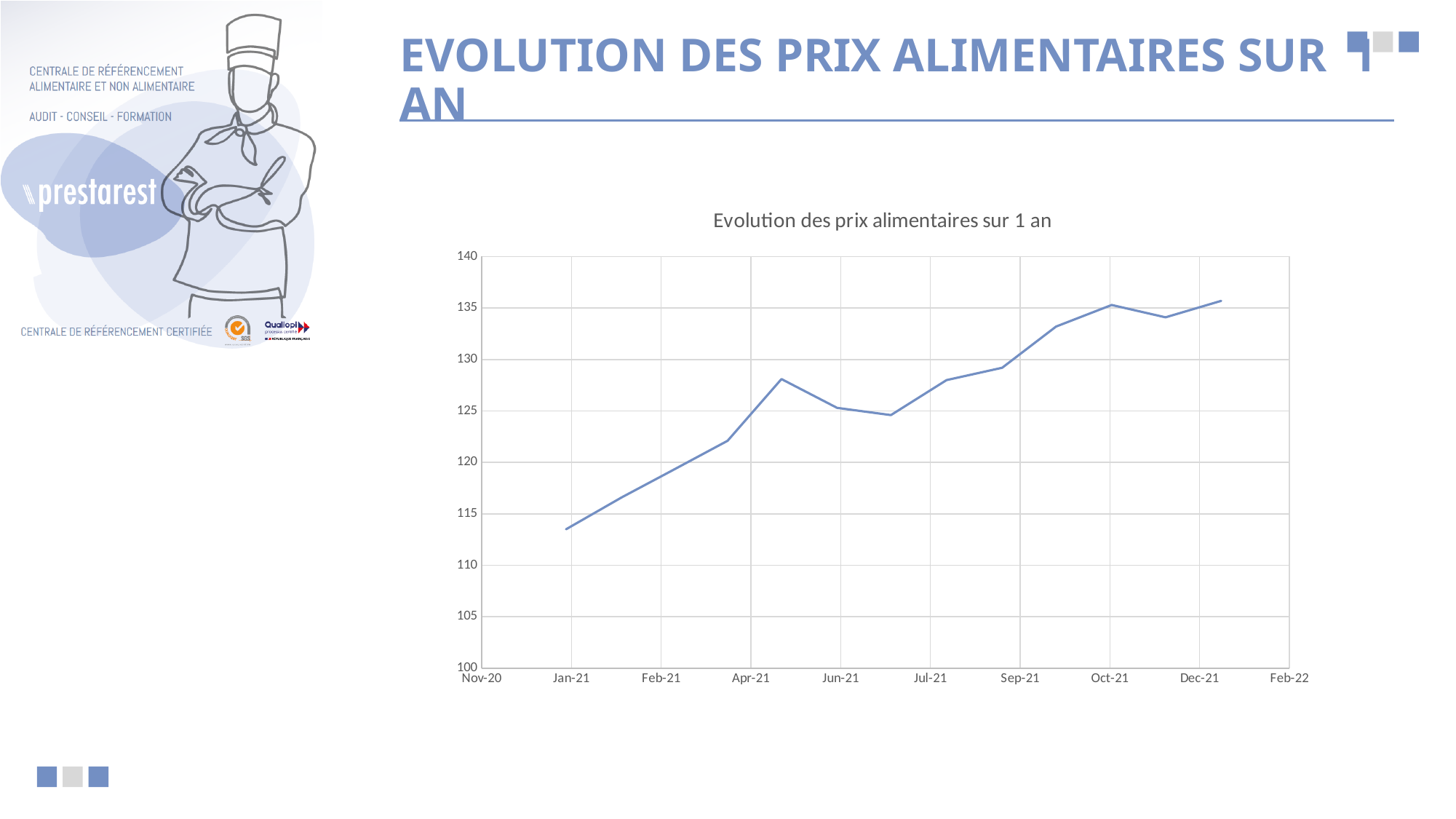
What is the title of the chart? Evolution des prix alimentaires sur 1 an How many date labels are shown on the x axis? 10 Which has the larger value, Apr-21 or Sep-21? Sep-21 Is the value for Jan-21 greater or less than 115? less Is the value for Jun-21 greater or less than 130? less Overall, do the values rise or fall from Jan-21 to the end of the series? rise Which has the larger value, Jan-21 or Oct-21? Oct-21 Is the value for Jul-21 greater or less than 120? greater What kind of chart is shown on the slide? line chart